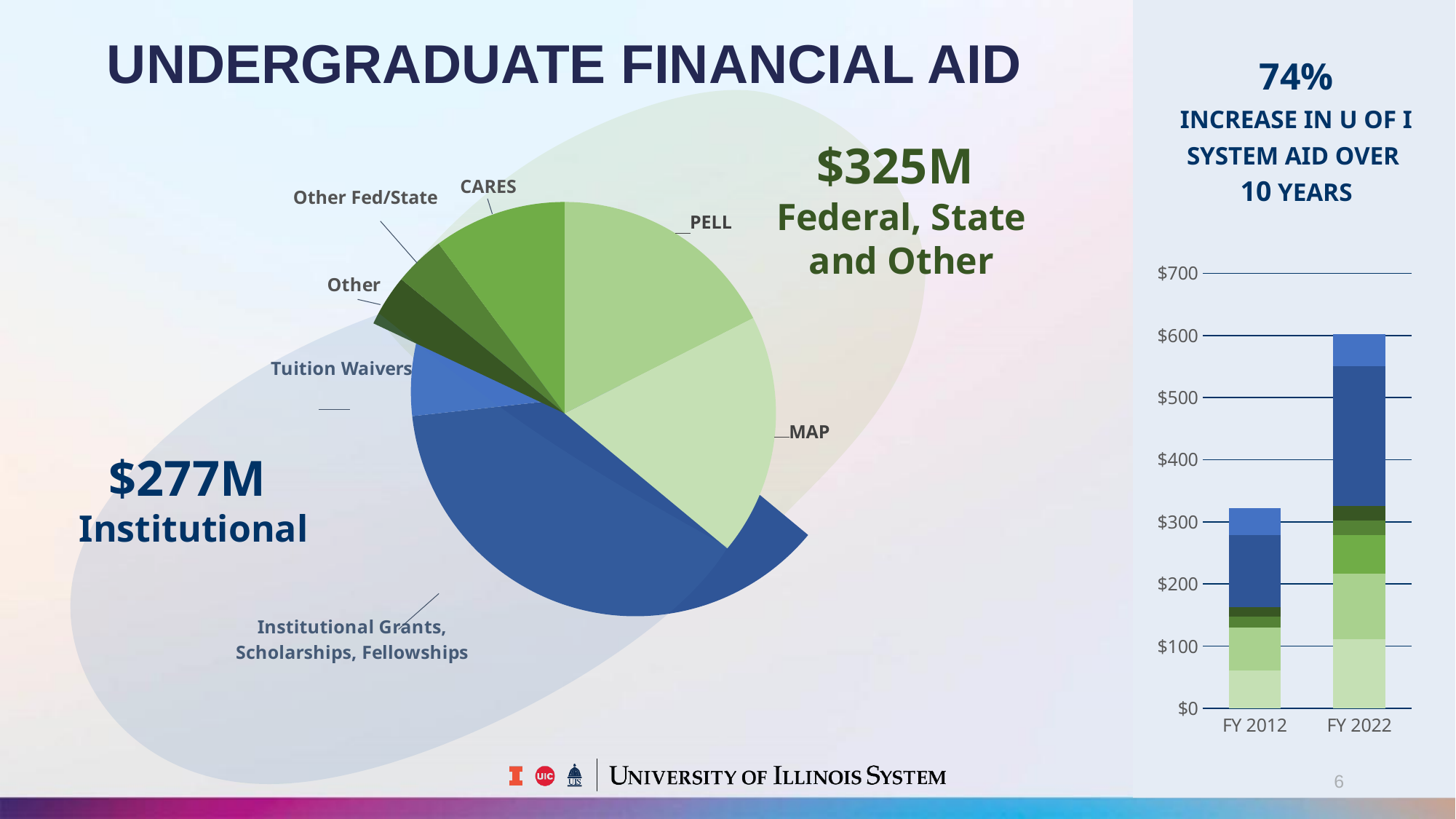
What kind of chart is the chart on the right of the slide, below the '74%' text? bar chart In the bar chart on the right, how many fiscal years are shown on the x axis? 2 In the pie chart on the left, which slice is the largest? Institutional Grants, Scholarships, Fellowships In the bar chart on the right, is the total for FY 2012 greater or less than $400? less In the bar chart on the right, which fiscal year has the taller stacked bar? FY 2022 In the bar chart on the right, do the stacked totals rise or fall from FY 2012 to FY 2022? rise In the bar chart on the right, is the total for FY 2022 greater or less than $500? greater What kind of chart is the large chart on the left of the slide? pie chart In the pie chart on the left, how many slices are labelled? 7 In the pie chart on the left, which slice is larger: Institutional Grants, Scholarships, Fellowships or Tuition Waivers? Institutional Grants, Scholarships, Fellowships In the pie chart on the left, which slice is larger: PELL or CARES? PELL According to the text next to the pie chart, what is the total amount of Federal, State and Other aid? $325M